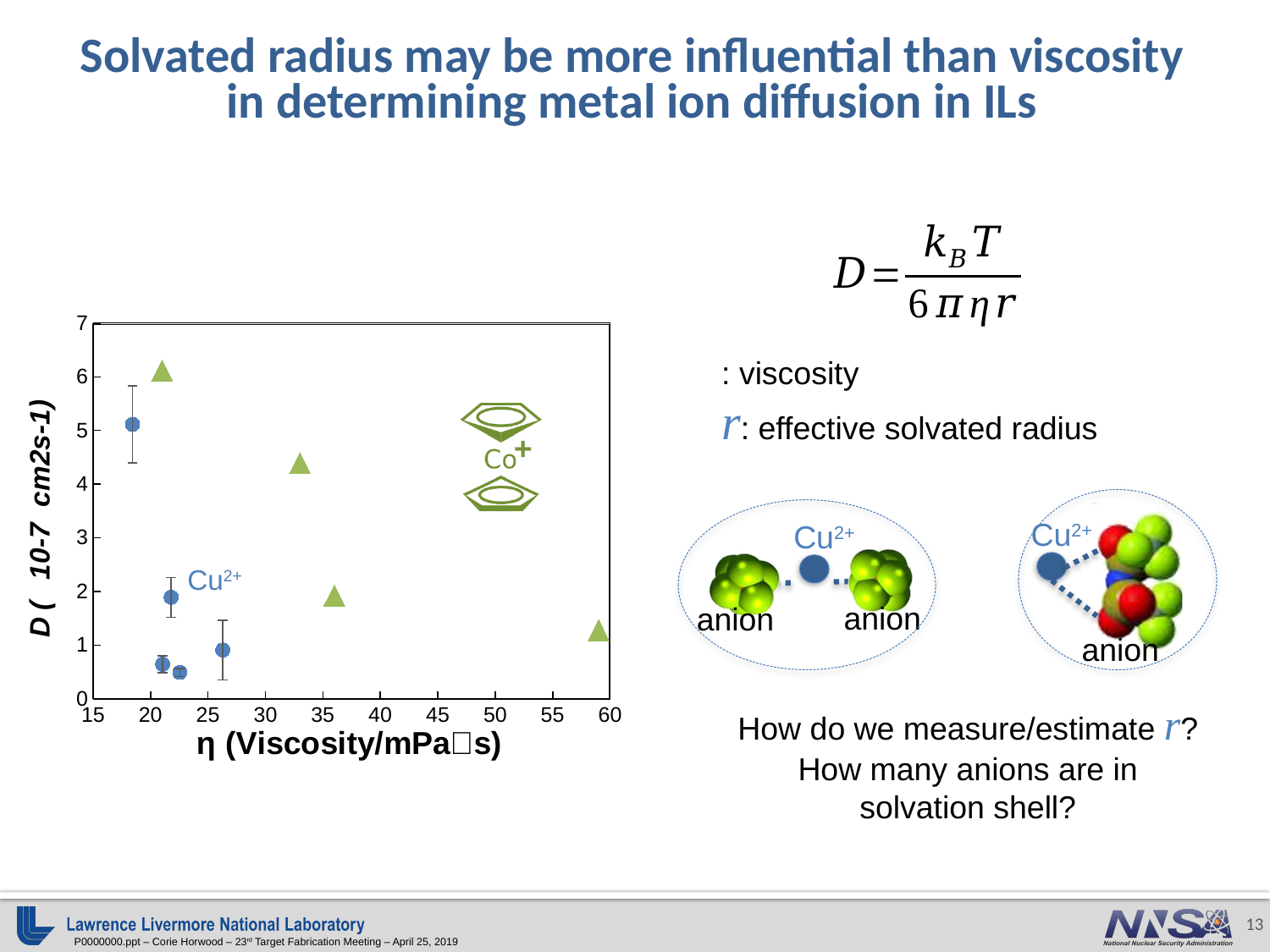
How many Cu2+ data points (blue circles) are plotted? 5 Is the D value for the Co+ point at the lowest viscosity (near 20 mPa·s) greater or less than 5? greater How many Co+ data points (green triangles) are plotted? 4 How many series are plotted in the chart? 2 Do the D values for Co+ rise or fall as viscosity increases along the x axis? fall Which has the larger D value: the Co+ point near 33 mPa·s or the Cu2+ point near 26 mPa·s? Co+ point near 33 mPa·s Which series contains the point with the highest D value in the chart? Co+ Is the D value for the Cu2+ point at the lowest viscosity (below 20 mPa·s) greater or less than 4? greater What kind of chart is shown on the slide? Scatter chart What is the label of the x axis? η (Viscosity/mPa·s) Which two ions are plotted as series in the chart? Cu2+ and Co+ Is the D value for the Co+ point at the highest viscosity (near 60 mPa·s) greater or less than 2? less